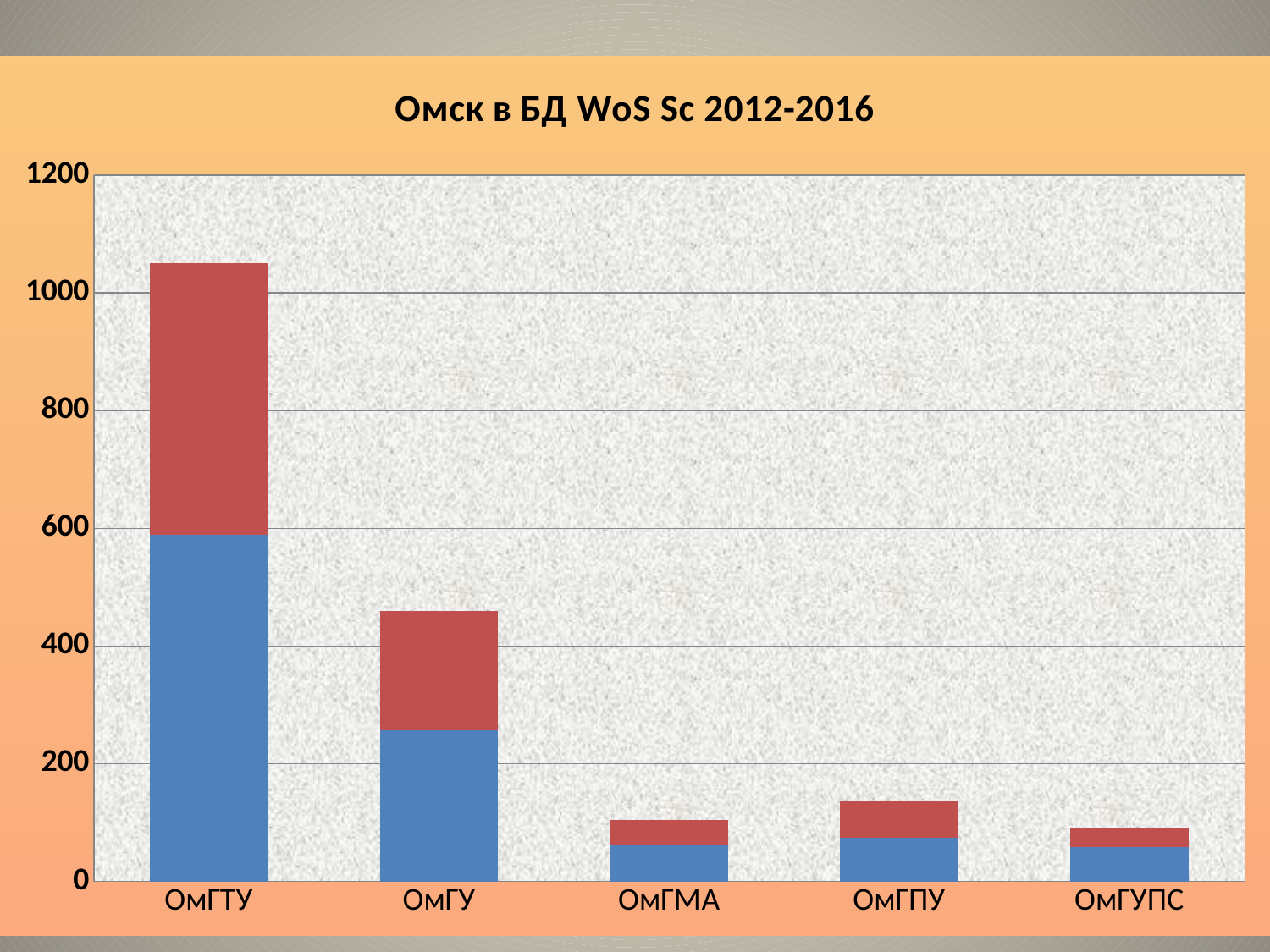
Is the total bar height for ОмГУПС greater or less than 200? less What is the title of the chart? Омск в БД WoS Sc 2012-2016 How many categories are shown on the x axis of the chart? 5 Which category has the tallest bar in the chart? ОмГТУ Which bar is taller, ОмГУ or ОмГПУ? ОмГУ What two colours are used for the segments of the stacked bars? blue and red Is the total bar height for ОмГУ greater or less than 600? less Is the total bar height for ОмГМА greater or less than 200? less What kind of chart is shown on the slide? stacked bar chart Which bar is taller, ОмГПУ or ОмГМА? ОмГПУ